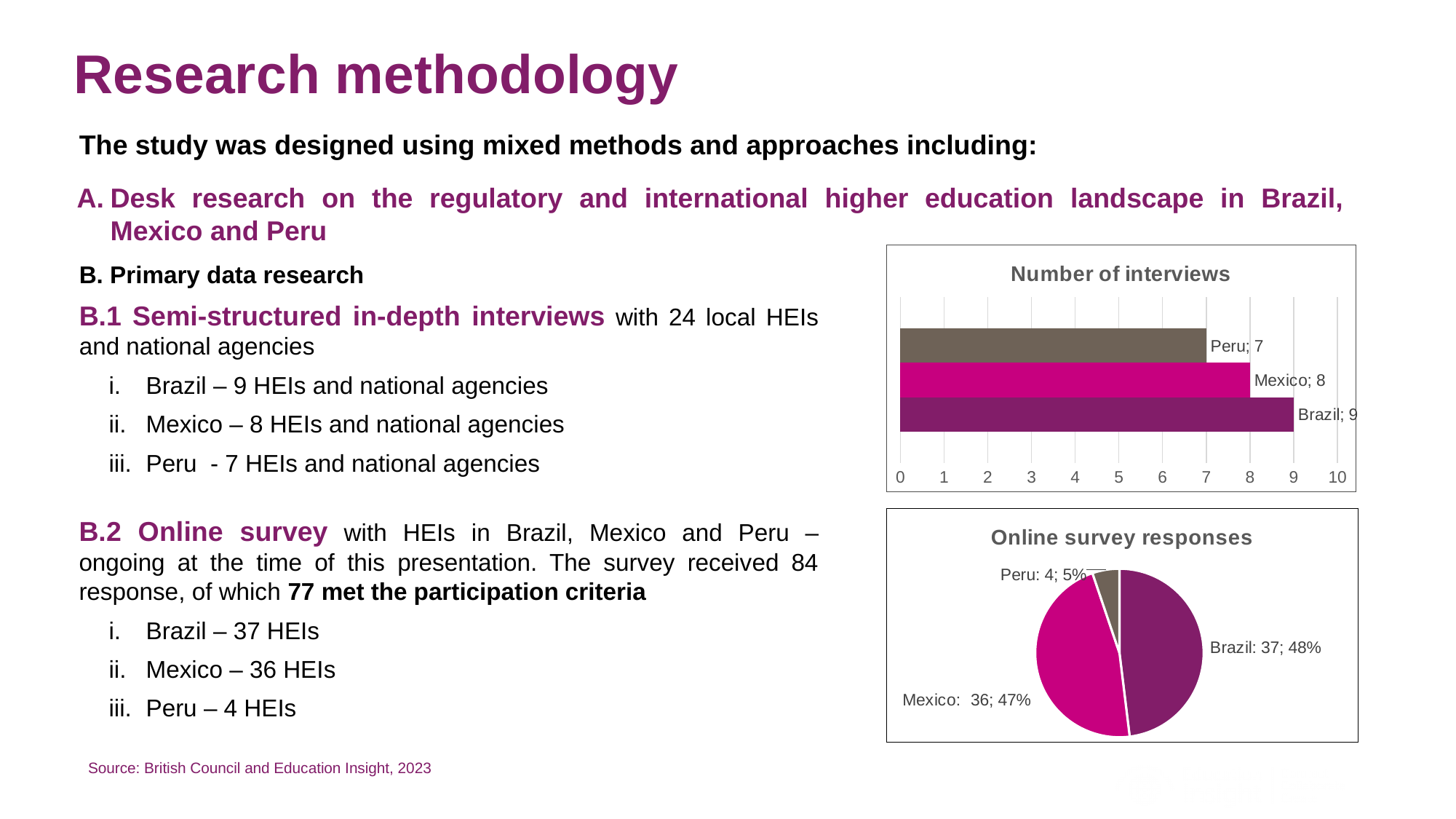
In the 'Number of interviews' chart, which country has the lowest number of interviews? Peru In the 'Online survey responses' chart, which country has the smallest slice? Peru In the 'Number of interviews' chart, how many interviews were conducted in Peru? 7 What kind of chart is the 'Online survey responses' chart? Pie chart In the 'Online survey responses' chart, what share of responses came from Mexico? 47% In the 'Number of interviews' chart, what is the difference between the number of interviews in Brazil and Peru? 2 In the 'Online survey responses' chart, how many responses came from Brazil? 37 In the 'Number of interviews' chart, how many countries are shown? 3 In the 'Number of interviews' chart, how many interviews were conducted in Mexico? 8 What kind of chart is the 'Number of interviews' chart? Bar chart In the 'Number of interviews' chart, which country has the highest number of interviews? Brazil In the 'Online survey responses' chart, which is larger: the number of responses from Brazil or from Mexico? Brazil